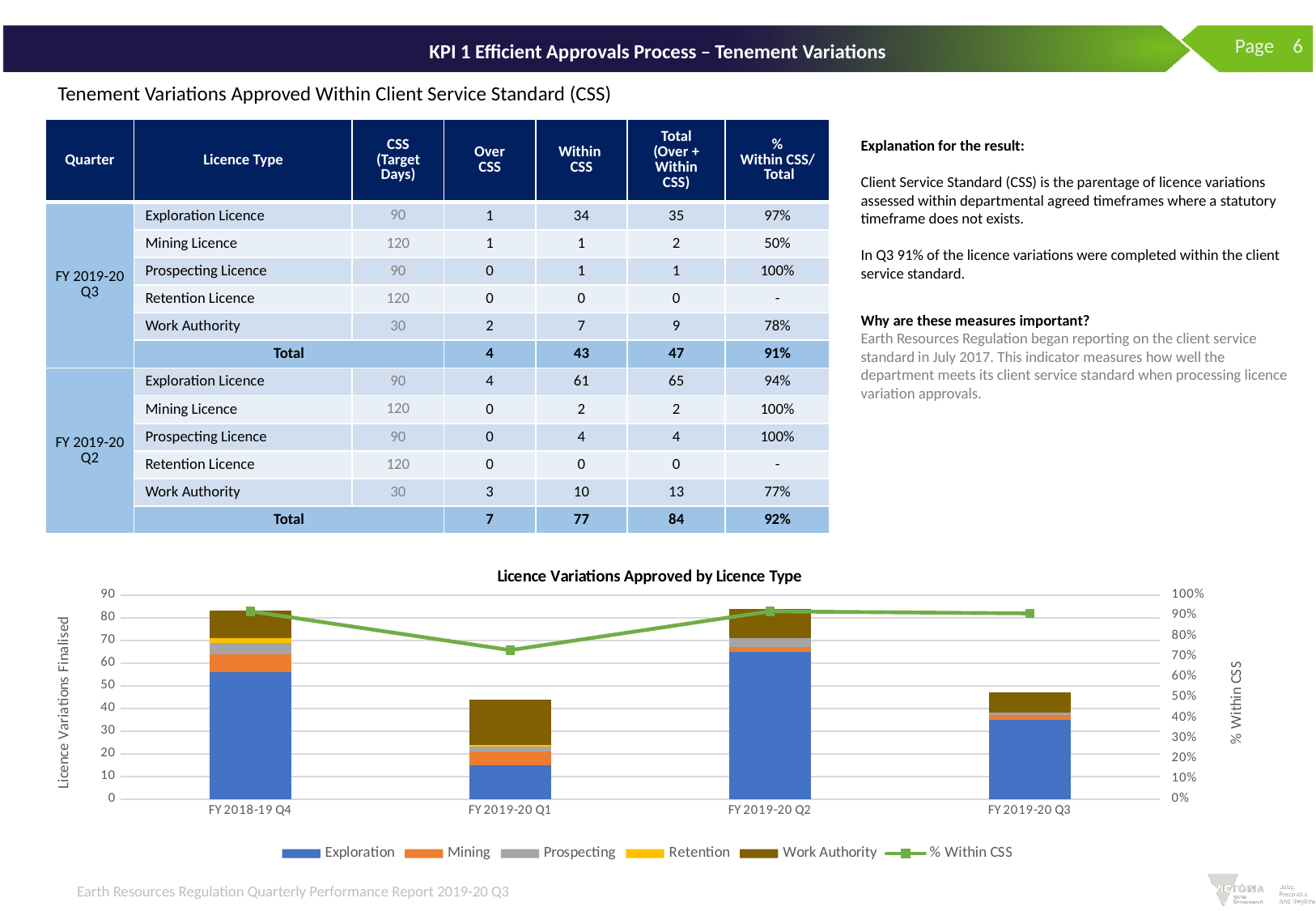
In which quarter is the % Within CSS line at its lowest? FY 2019-20 Q1 Which has the taller stacked bar, FY 2019-20 Q1 or FY 2019-20 Q2? FY 2019-20 Q2 What kind of chart is shown on the slide? Stacked bar chart with a line Is the % Within CSS value for FY 2019-20 Q1 greater or less than 80%? less How many quarters are shown along the x axis of the chart? 4 Is the total stacked bar for FY 2019-20 Q1 greater or less than 50? less How many series does the chart legend list? 6 Is the total stacked bar for FY 2019-20 Q2 greater or less than 80? greater What is the label of the right-hand vertical axis of the chart? % Within CSS Does the % Within CSS line rise or fall from FY 2018-19 Q4 to FY 2019-20 Q1? fall What is the title of the chart on the slide? Licence Variations Approved by Licence Type